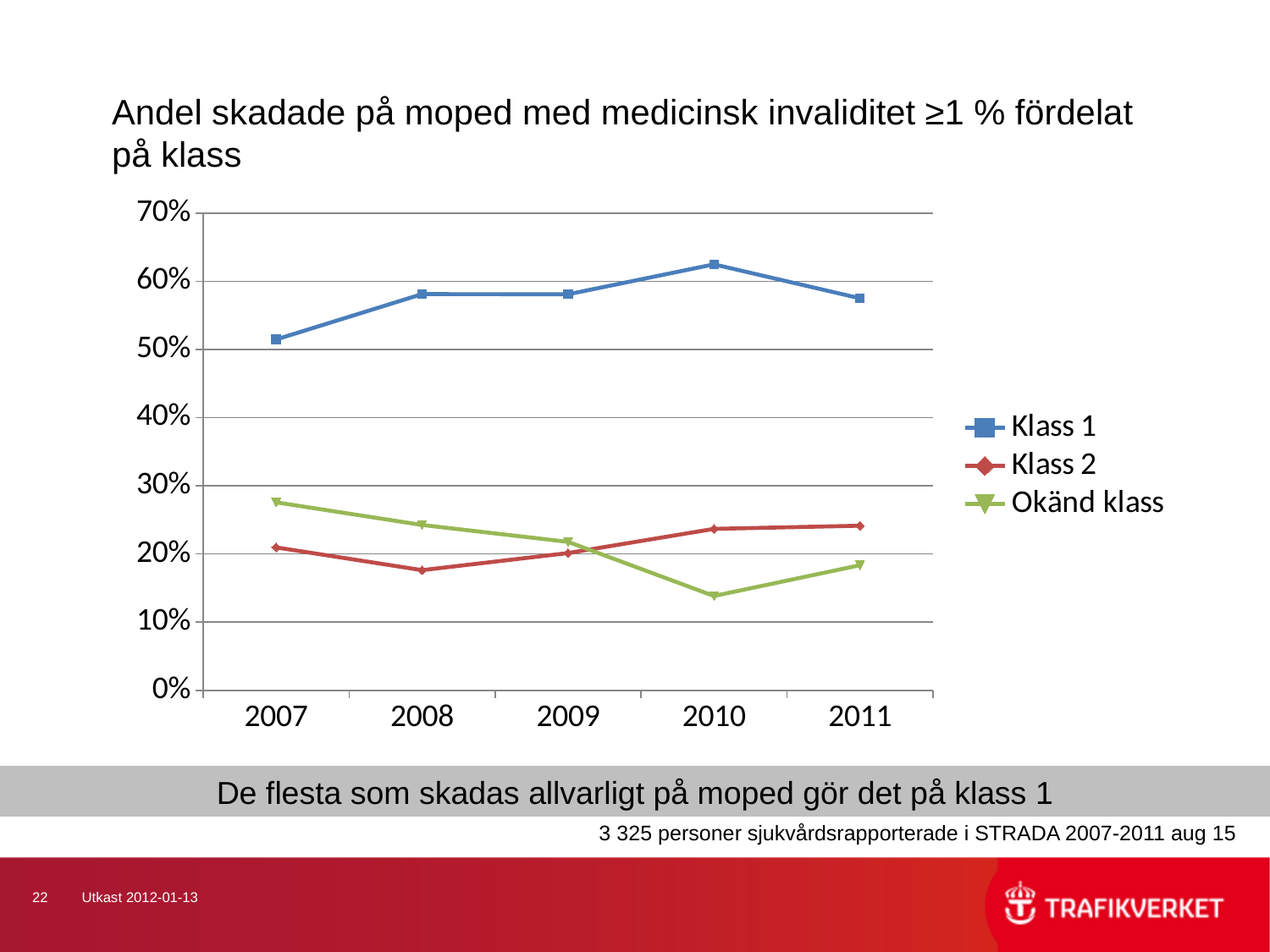
How many years are shown on the x axis? 5 In which year does Klass 2 reach its lowest value? 2008 What kind of chart is shown on the slide? Line chart Is the value for Okänd klass in 2010 greater or less than 20%? less In 2011, which is higher: Klass 2 or Okänd klass? Klass 2 Does the Okänd klass line rise or fall from 2007 to 2010? Fall In 2007, which is higher: Klass 2 or Okänd klass? Okänd klass In which year does Okänd klass reach its lowest value? 2010 How many series does the legend list? 3 Is the value for Klass 2 in 2008 greater or less than 20%? less In which year does Klass 1 reach its highest value? 2010 Is the value for Klass 1 in 2010 greater or less than 60%? greater